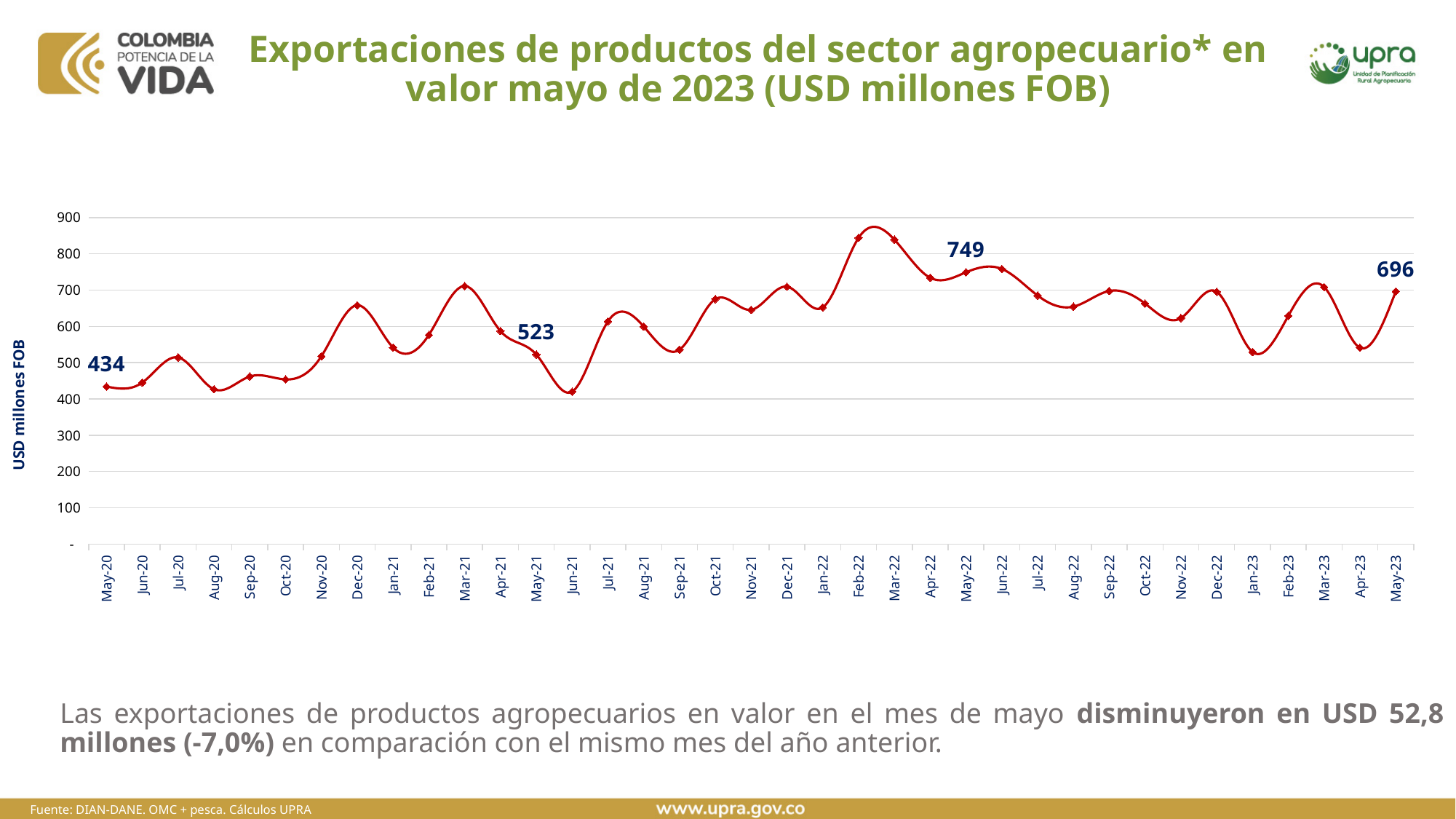
Is the value for Jun-21 greater or less than 500? less Which is larger, the value for May-22 or the value for May-23? May-22 What is the value for May-21? 523 Is the value for Feb-22 greater or less than 800? greater What is the difference between the values for May-22 and May-23? 53 What is the value for May-23? 696 What kind of chart is shown on the slide? line chart What is the difference between the values for May-21 and May-20? 89 How many monthly data points are plotted on the chart? 37 What is the value for May-22? 749 Which month has the highest value on the chart? Feb-22 What is the value for May-20? 434